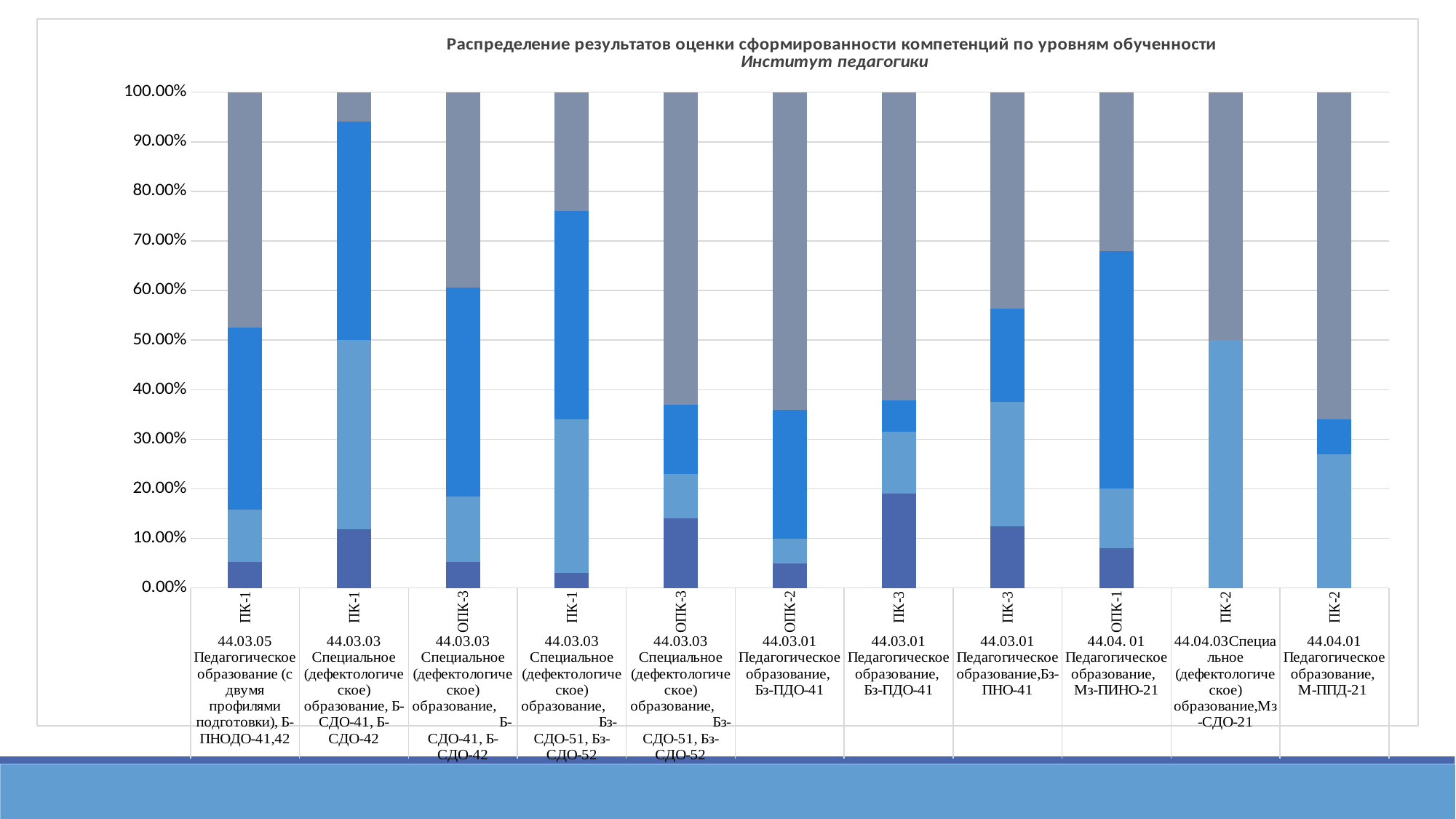
Is the top of the medium-blue segment for ПК-2 (44.04.01, М-ППД-21) greater or less than 30.00%? greater What is the total height of each stacked bar, as read from the y axis? 100.00% What kind of chart is shown on the slide? Stacked bar chart Is the top of the medium-blue segment for ПК-1 (44.03.03, Б-СДО-41, Б-СДО-42) greater or less than 90.00%? greater Which bar has the largest grey (top) segment? ПК-2 (44.04.01, М-ППД-21) Is the top of the medium-blue segment for ПК-1 (44.03.03, Бз-СДО-51, Бз-СДО-52) greater or less than 70.00%? greater What is the title of the chart? Распределение результатов оценки сформированности компетенций по уровням обученности How many bars (categories) are plotted in the chart? 11 Which institute is named in the chart's subtitle? Институт педагогики Which bar has the smallest grey (top) segment? ПК-1 (44.03.03, Б-СДО-41, Б-СДО-42)